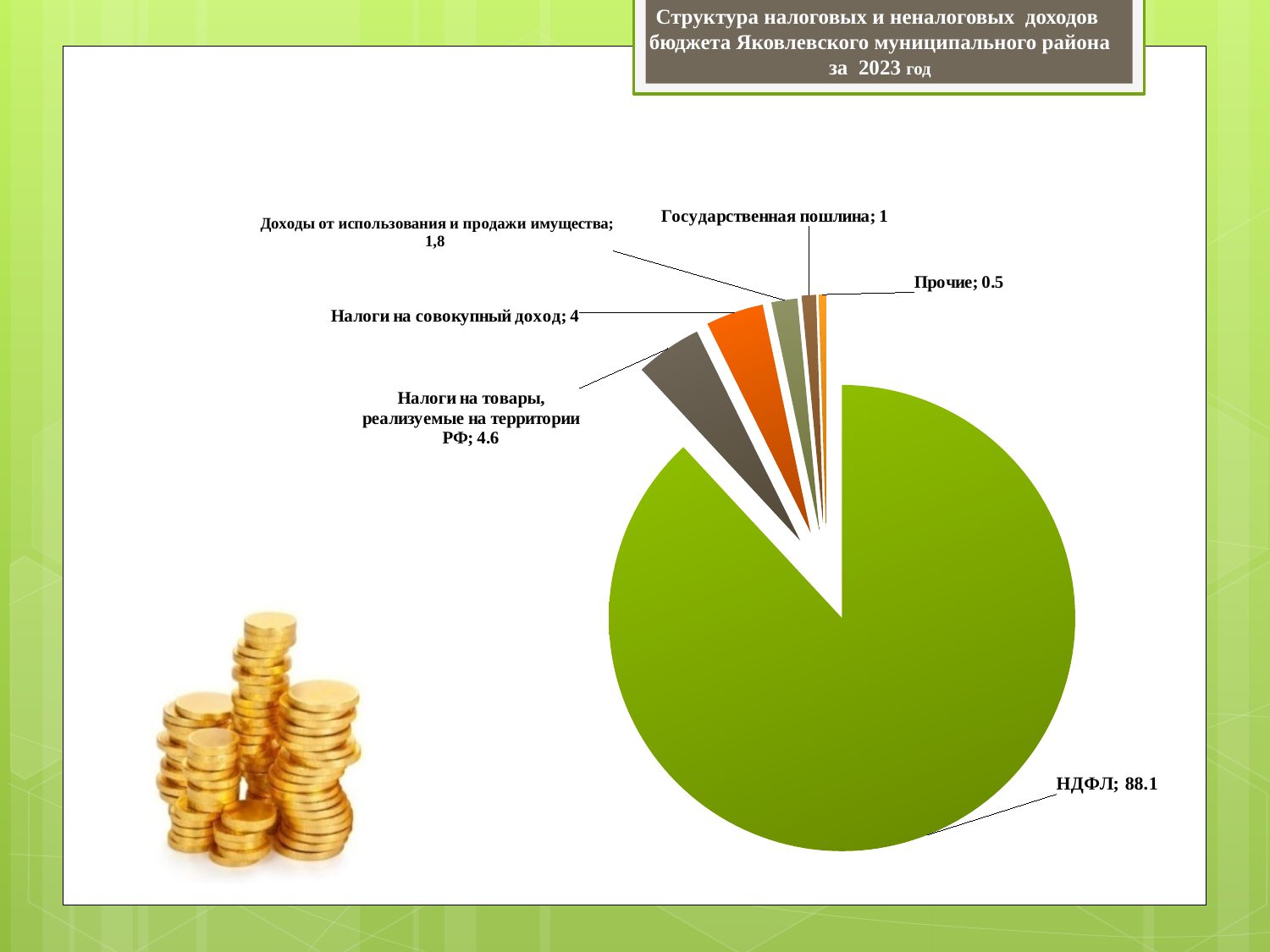
What type of chart is shown on the slide? pie chart Which is larger: Налоги на совокупный доход or Государственная пошлина? Налоги на совокупный доход What is the value for Доходы от использования и продажи имущества? 1,8 Which category has the largest slice of the pie? НДФЛ What is the difference between the values for НДФЛ and Налоги на товары, реализуемые на территории РФ? 83.5 What is the value for Налоги на товары, реализуемые на территории РФ? 4.6 What is the value for НДФЛ in the pie chart? 88.1 How many slices does the pie chart have? 6 What is the value for Государственная пошлина? 1 What is the value for Прочие? 0.5 What is the value for Налоги на совокупный доход? 4 Which category has the smallest slice of the pie? Прочие